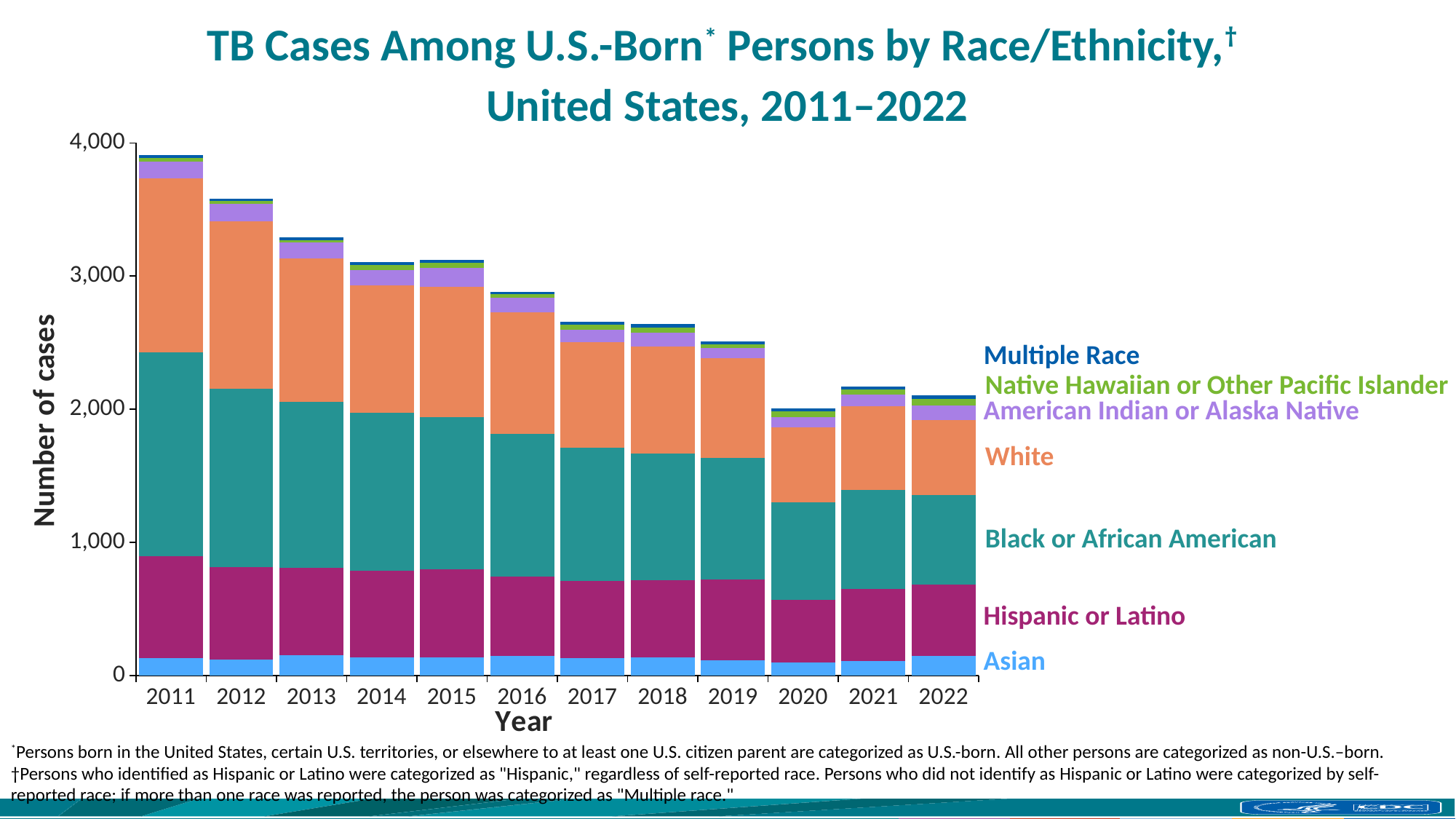
Which year has the larger total number of cases, 2011 or 2022? 2011 What kind of chart is shown on the slide? Stacked bar chart What is the label of the y axis? Number of cases Is the total number of cases in 2016 greater or less than 3,000? less Which year has the lowest total number of TB cases among U.S.-born persons? 2020 Which race/ethnicity group accounts for the largest segment of the 2011 bar? Black or African American How many years are shown along the x axis of the chart? 12 Which year has the highest total number of TB cases among U.S.-born persons? 2011 Do the total number of cases generally rise or fall from 2011 to 2022? Fall Is the total number of cases in 2011 greater or less than 3,000? greater How many race/ethnicity series does the legend list? 7 Is the total number of cases in 2020 greater or less than 3,000? less